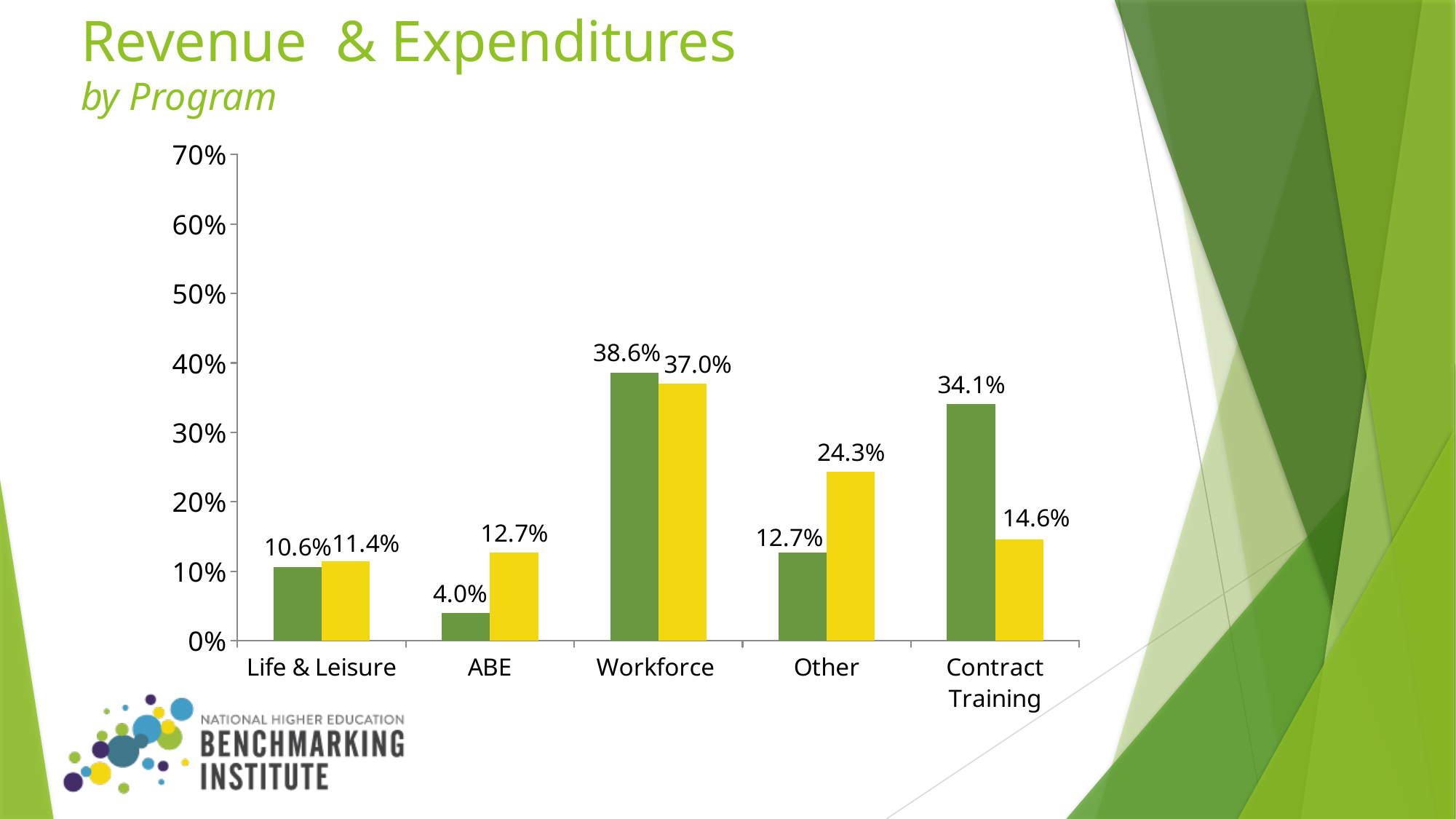
What is the value of the green bar for ABE? 4.0% For Other, which is larger: the green bar or the yellow bar? The yellow bar (24.3%) Which program has the highest yellow bar? Workforce What is the title of the slide containing the chart? Revenue & Expenditures by Program Which program has the lowest green bar? ABE What is the value of the yellow bar for Other? 24.3% Which program has the highest green bar? Workforce What kind of chart is shown on the slide? Bar chart How many programs are shown on the x axis? 5 What is the value of the yellow bar for Contract Training? 14.6% What is the value of the green bar for Workforce? 38.6% For Contract Training, what is the difference between the green bar (34.1%) and the yellow bar (14.6%)? 19.5 percentage points